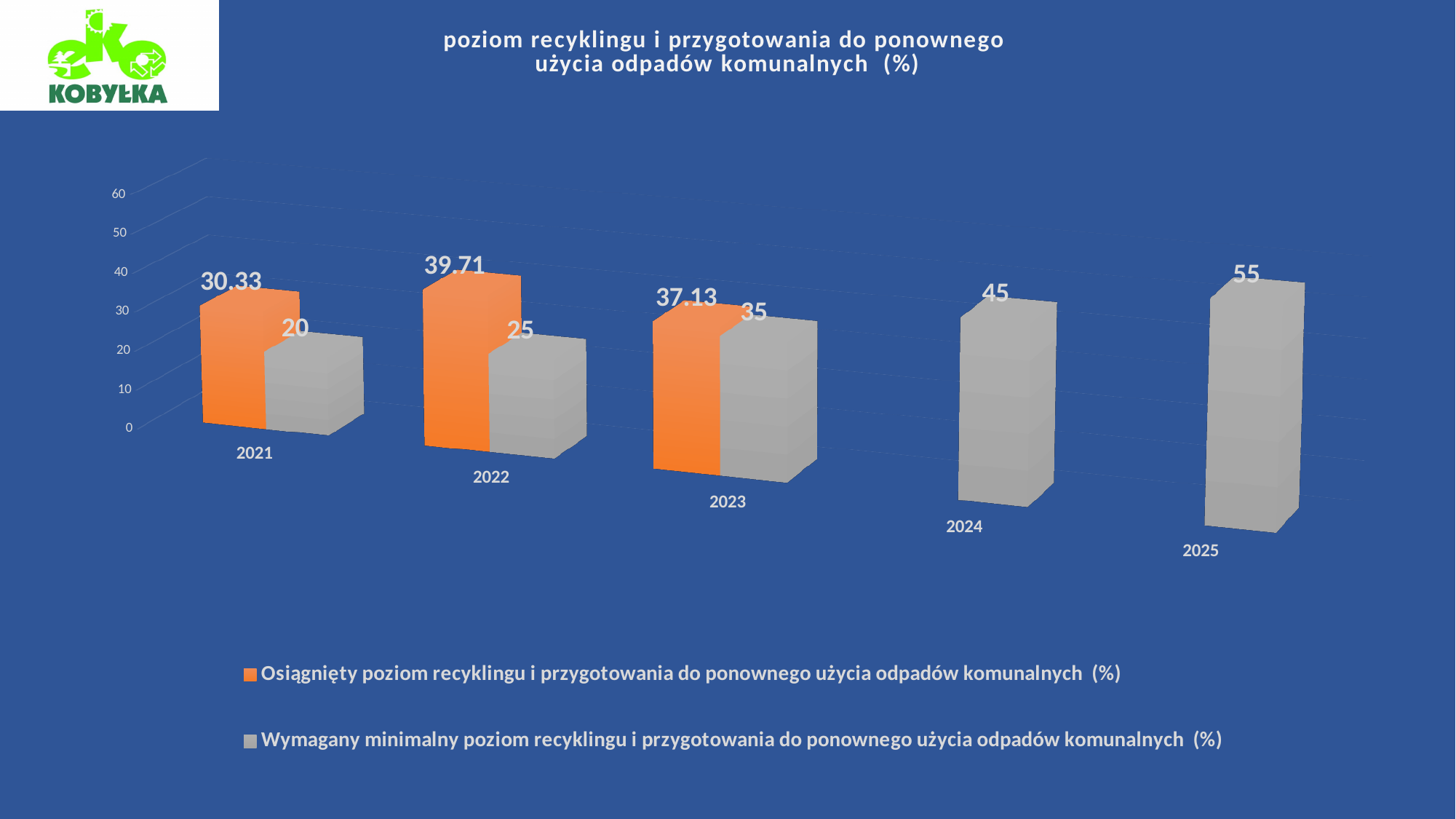
What kind of chart is shown on the slide? bar chart Does the required minimum recycling level rise or fall from 2021 to 2025? rise In which year is the required minimum recycling level (Wymagany minimalny poziom) lowest? 2021 What is the achieved recycling level (Osiągnięty poziom) for 2022? 39.71 In which year is the achieved recycling level (Osiągnięty poziom) highest? 2022 Which is larger in 2022: the achieved recycling level or the required minimum level? the achieved recycling level (39.71) How many years are shown on the x axis? 5 What is the difference between the achieved level and the required minimum level in 2023? 2.13 What is the required minimum recycling level (Wymagany minimalny poziom) for 2023? 35 What is the required minimum recycling level (Wymagany minimalny poziom) for 2024? 45 How many series does the legend list? 2 What is the achieved recycling level (Osiągnięty poziom) for 2021? 30.33